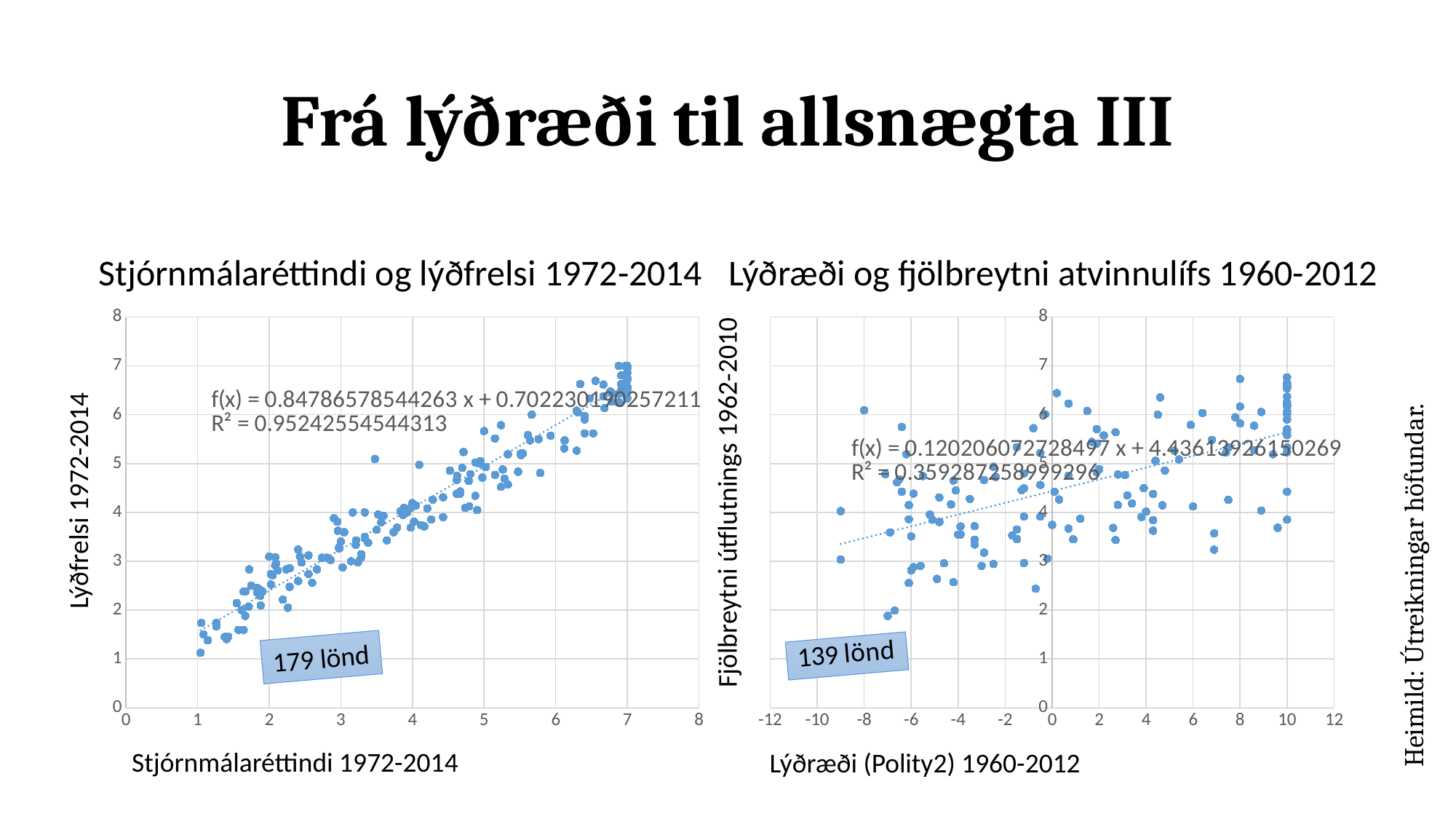
In the left chart, "Stjórnmálaréttindi og lýðfrelsi 1972-2014", do the plotted values rise or fall as the x-axis value increases? Rise What kind of chart is the right chart, titled "Lýðræði og fjölbreytni atvinnulífs 1960-2012"? Scatter chart In the right chart, "Lýðræði og fjölbreytni atvinnulífs 1960-2012", what is the slope coefficient in the trend line equation? 0.120206072728497 In the right chart, "Lýðræði og fjölbreytni atvinnulífs 1960-2012", does the trend line rise or fall from left to right? Rise What is the y-axis label of the left chart, "Stjórnmálaréttindi og lýðfrelsi 1972-2014"? Lýðfrelsi 1972-2014 In the left chart, "Stjórnmálaréttindi og lýðfrelsi 1972-2014", how many countries (lönd) does the label say are plotted? 179 lönd In the right chart, "Lýðræði og fjölbreytni atvinnulífs 1960-2012", how many countries (lönd) does the label say are plotted? 139 lönd What is the x-axis label of the right chart, "Lýðræði og fjölbreytni atvinnulífs 1960-2012"? Lýðræði (Polity2) 1960-2012 Which chart has the higher R² value for its trend line, the left chart or the right chart? The left chart (Stjórnmálaréttindi og lýðfrelsi 1972-2014) In the left chart, "Stjórnmálaréttindi og lýðfrelsi 1972-2014", what is the trend line equation shown? f(x) = 0.84786578544263 x + 0.702230190257211 What kind of chart is the left chart, titled "Stjórnmálaréttindi og lýðfrelsi 1972-2014"? Scatter chart In the left chart, "Stjórnmálaréttindi og lýðfrelsi 1972-2014", what is the R² value shown for the trend line? 0.95242554544313